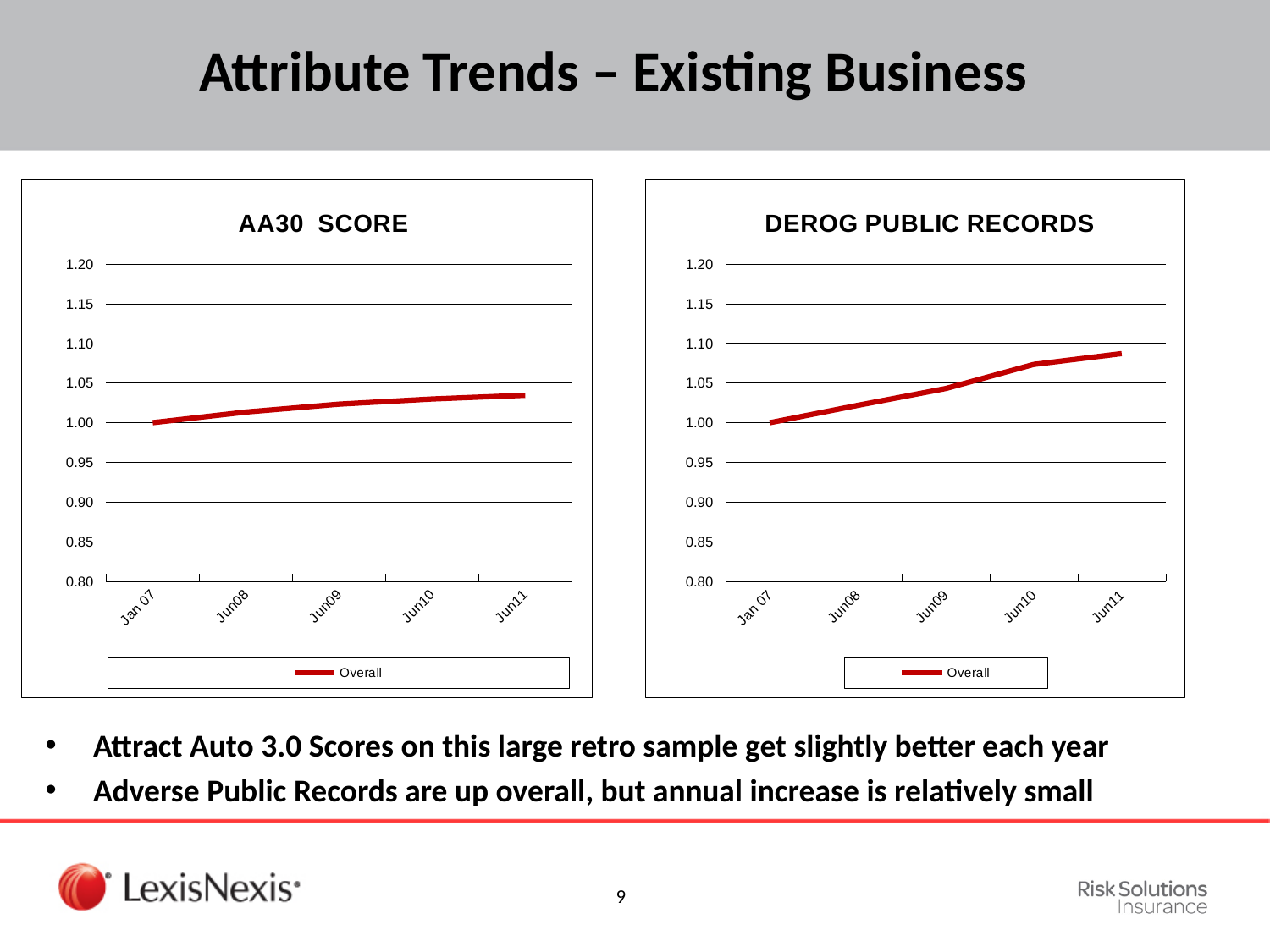
On the DEROG PUBLIC RECORDS chart, do the values rise or fall along the x axis? rise At Jun11, which chart shows the larger value, AA30 SCORE or DEROG PUBLIC RECORDS? DEROG PUBLIC RECORDS What kind of chart is the AA30 SCORE chart? line chart On the DEROG PUBLIC RECORDS chart, what is the value for Jan 07? 1.00 On the AA30 SCORE chart, what is the value for Jan 07? 1.00 How many points are plotted on the DEROG PUBLIC RECORDS chart? 5 On the AA30 SCORE chart, is the value for Jun11 greater or less than 1.05? less How many series does the legend of the AA30 SCORE chart list? 1 On the DEROG PUBLIC RECORDS chart, which period has the highest value? Jun11 On the DEROG PUBLIC RECORDS chart, is the value for Jun11 greater or less than 1.05? greater What is the name of the series shown in the legend of the DEROG PUBLIC RECORDS chart? Overall On the AA30 SCORE chart, do the values rise or fall from Jan 07 to Jun11? rise